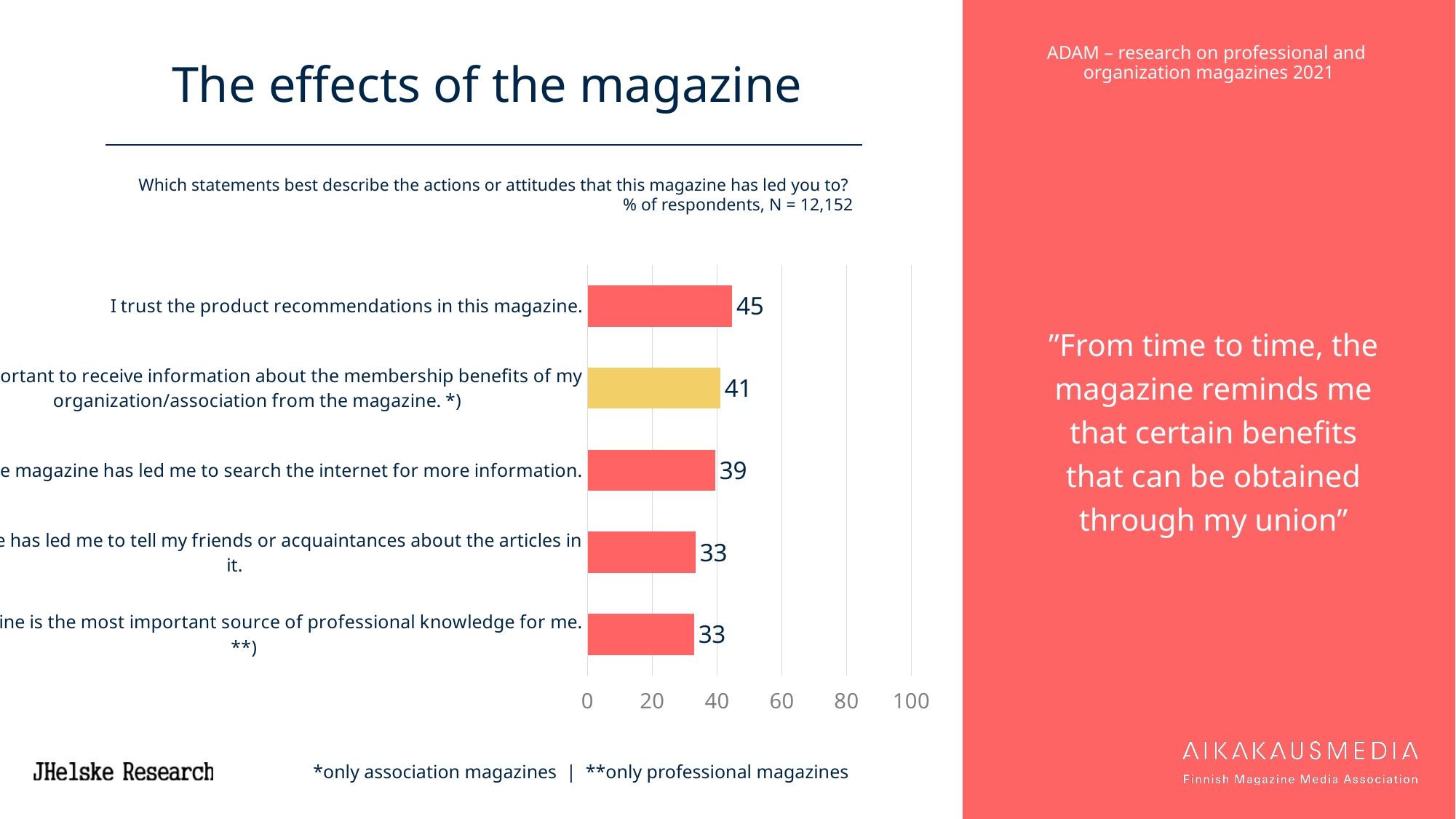
How many statements (bars) are shown in the chart? 5 What is the value for the statement that the magazine has led me to tell my friends or acquaintances about the articles in it? 33 Is the value for "I trust the product recommendations in this magazine." greater or less than 60? less What is the difference between the value for "I trust the product recommendations in this magazine." and the value for the statement about searching the internet for more information? 6 What is the value for the statement that the magazine is the most important source of professional knowledge for me? 33 What is the value for "I trust the product recommendations in this magazine."? 45 What is the value for the statement about receiving information about the membership benefits of my organization/association from the magazine? 41 Which is larger: the value for the statement about membership benefits information or the value for the statement about telling friends about the articles? the statement about membership benefits information Which bar is coloured yellow instead of red? the statement about receiving information about the membership benefits of my organization/association from the magazine What is the value for the statement that the magazine has led me to search the internet for more information? 39 What kind of chart is shown on the slide? bar chart Which statement has the highest value? I trust the product recommendations in this magazine.